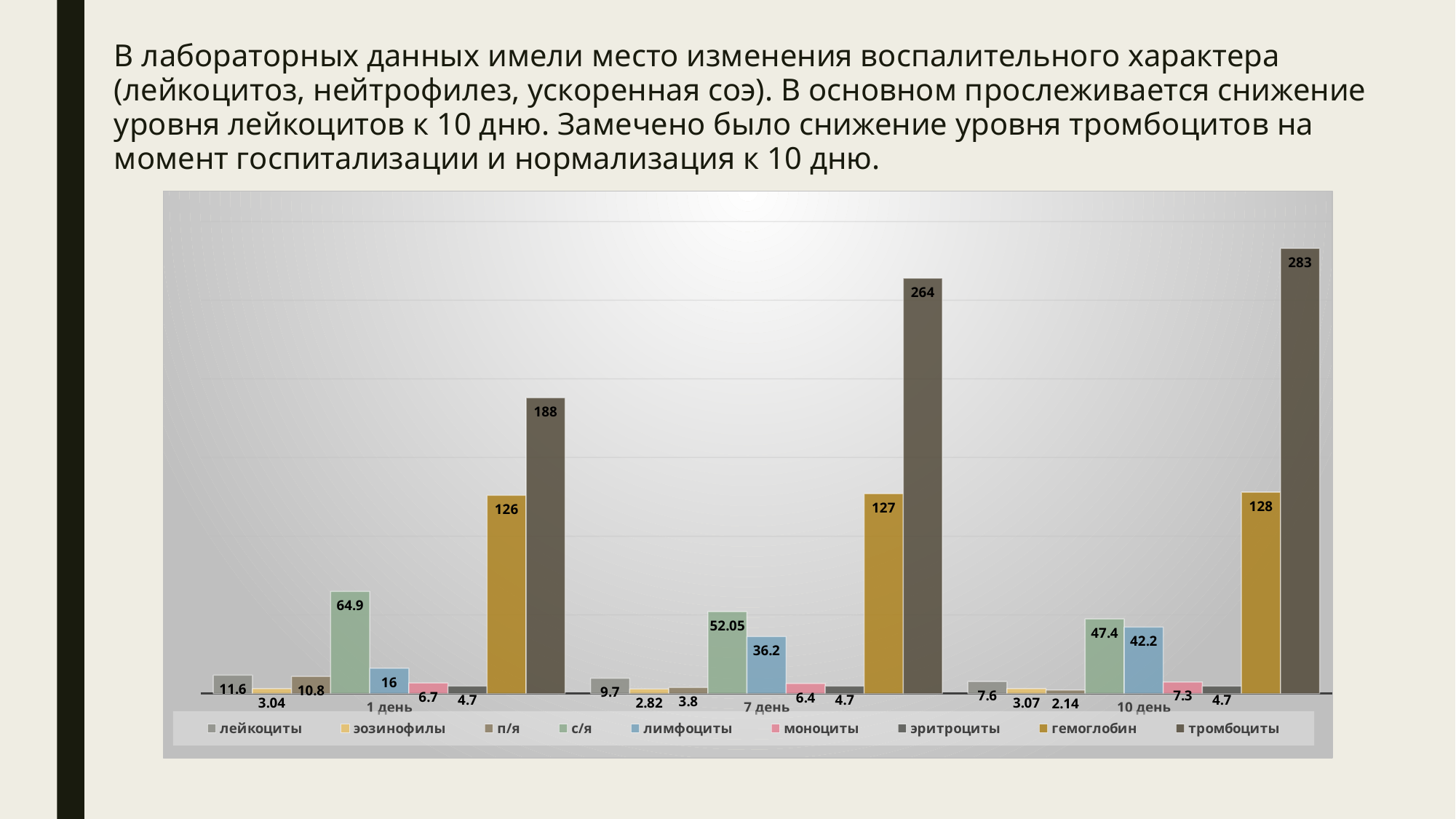
Do the values for лейкоциты rise or fall from 1 день to 10 день? fall What is the difference between тромбоциты on 10 день and on 1 день? 95 How many day categories are shown on the x axis? 3 On which day is тромбоциты highest? 10 день What is the value of с/я on 10 день? 47.4 What type of chart is shown on the slide? bar chart What is the value of гемоглобин on 7 день? 127 On which day is лейкоциты lowest? 10 день What is the value of тромбоциты on 1 день? 188 What is the value of лимфоциты on 7 день? 36.2 Which is larger on 7 день: с/я or лимфоциты? с/я How many series does the legend list? 9